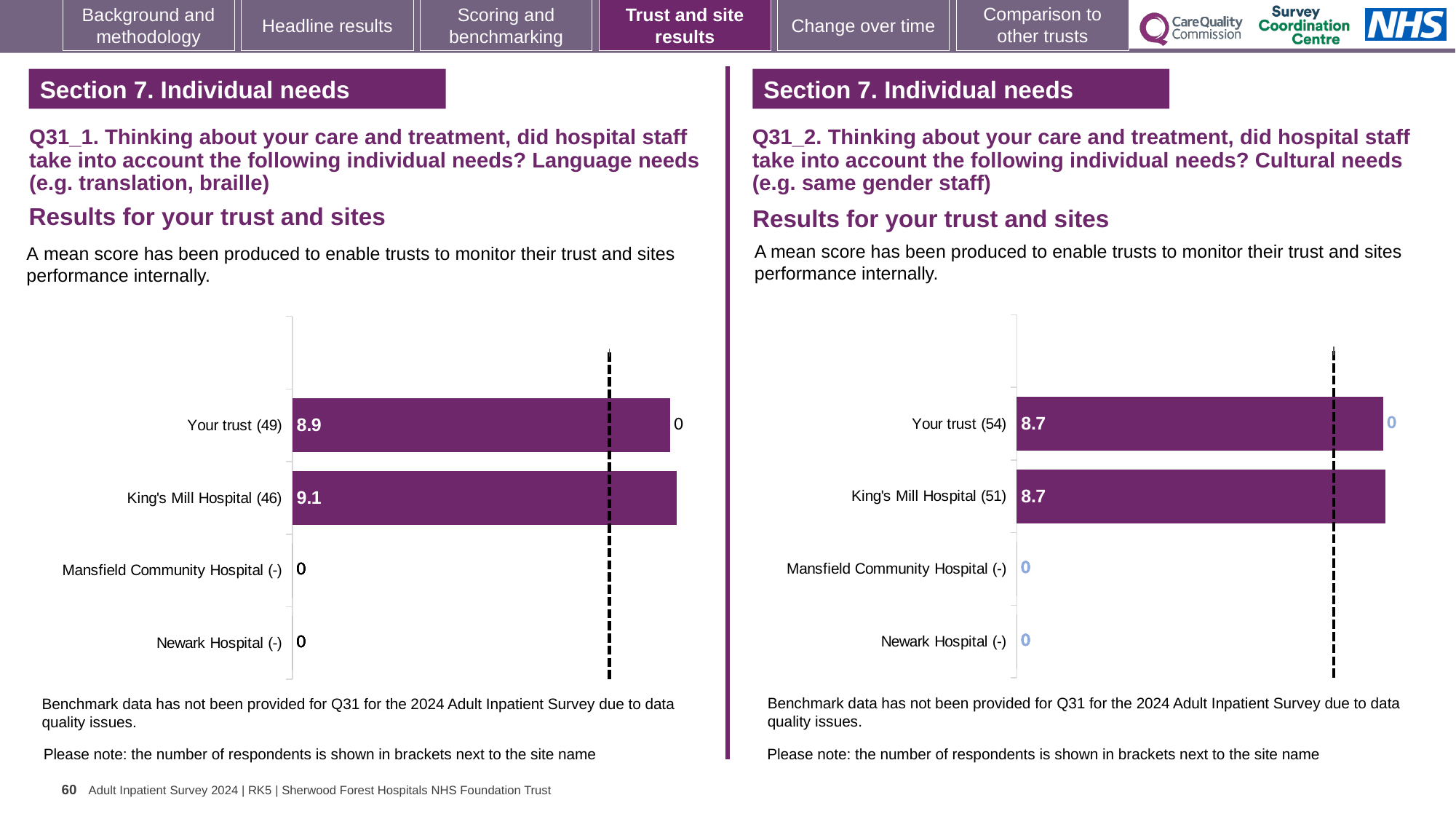
In the Q31_2 Cultural needs chart on the right, what is the mean score for Your trust (54)? 8.7 In the Q31_1 Language needs chart on the left, which is larger: the score for Your trust (49) or for King's Mill Hospital (46)? King's Mill Hospital (46) How many categories are listed on the y axis of the Q31_1 Language needs chart on the left? 4 In the Q31_1 Language needs chart on the left, which site has the highest mean score? King's Mill Hospital (46) How many respondents are shown in brackets for Your trust in the Q31_2 Cultural needs chart on the right? 54 In the Q31_1 Language needs chart on the left, what is the mean score for Your trust (49)? 8.9 In the Q31_2 Cultural needs chart on the right, what is the mean score for King's Mill Hospital (51)? 8.7 In the Q31_1 Language needs chart on the left, what is the difference between the scores for King's Mill Hospital (46) and Your trust (49)? 0.2 In the Q31_2 Cultural needs chart on the right, what is the difference between the scores for Your trust (54) and King's Mill Hospital (51)? 0 In the Q31_2 Cultural needs chart on the right, what value is shown for Mansfield Community Hospital (-)? 0 In the Q31_1 Language needs chart on the left, what is the mean score for King's Mill Hospital (46)? 9.1 What kind of chart is the Q31_2 Cultural needs chart on the right? Bar chart